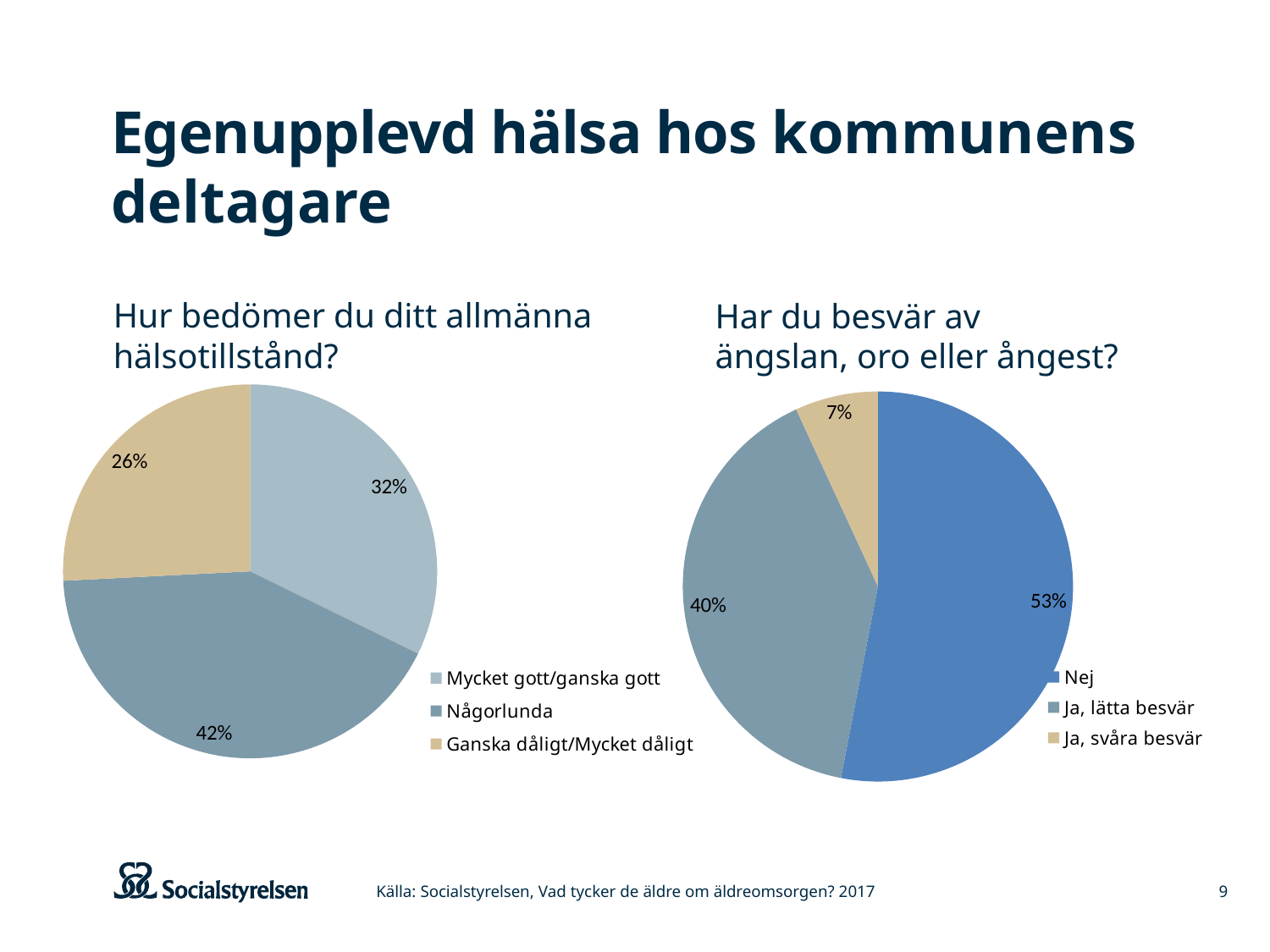
In the right chart (Har du besvär av ängslan, oro eller ångest?), what is the difference in percentage points between Ja, lätta besvär and Ja, svåra besvär? 33 percentage points In the right chart (Har du besvär av ängslan, oro eller ångest?), which category has the largest slice? Nej In the left chart (Hur bedömer du ditt allmänna hälsotillstånd?), what share is labelled for Någorlunda? 42% How many categories does the legend of the right chart (Har du besvär av ängslan, oro eller ångest?) list? 3 In the right chart (Har du besvär av ängslan, oro eller ångest?), what share is labelled for Nej? 53% In the right chart (Har du besvär av ängslan, oro eller ångest?), what share is labelled for Ja, svåra besvär? 7% In the left chart (Hur bedömer du ditt allmänna hälsotillstånd?), what share is labelled for Mycket gott/ganska gott? 32% In the left chart (Hur bedömer du ditt allmänna hälsotillstånd?), which category has the largest slice? Någorlunda In the left chart (Hur bedömer du ditt allmänna hälsotillstånd?), what is the difference in percentage points between Någorlunda and Ganska dåligt/Mycket dåligt? 16 percentage points What type of chart is used for the left chart (Hur bedömer du ditt allmänna hälsotillstånd?)? Pie chart In the right chart (Har du besvär av ängslan, oro eller ångest?), which is larger: Nej or Ja, lätta besvär? Nej In the left chart (Hur bedömer du ditt allmänna hälsotillstånd?), which category has the smallest slice? Ganska dåligt/Mycket dåligt